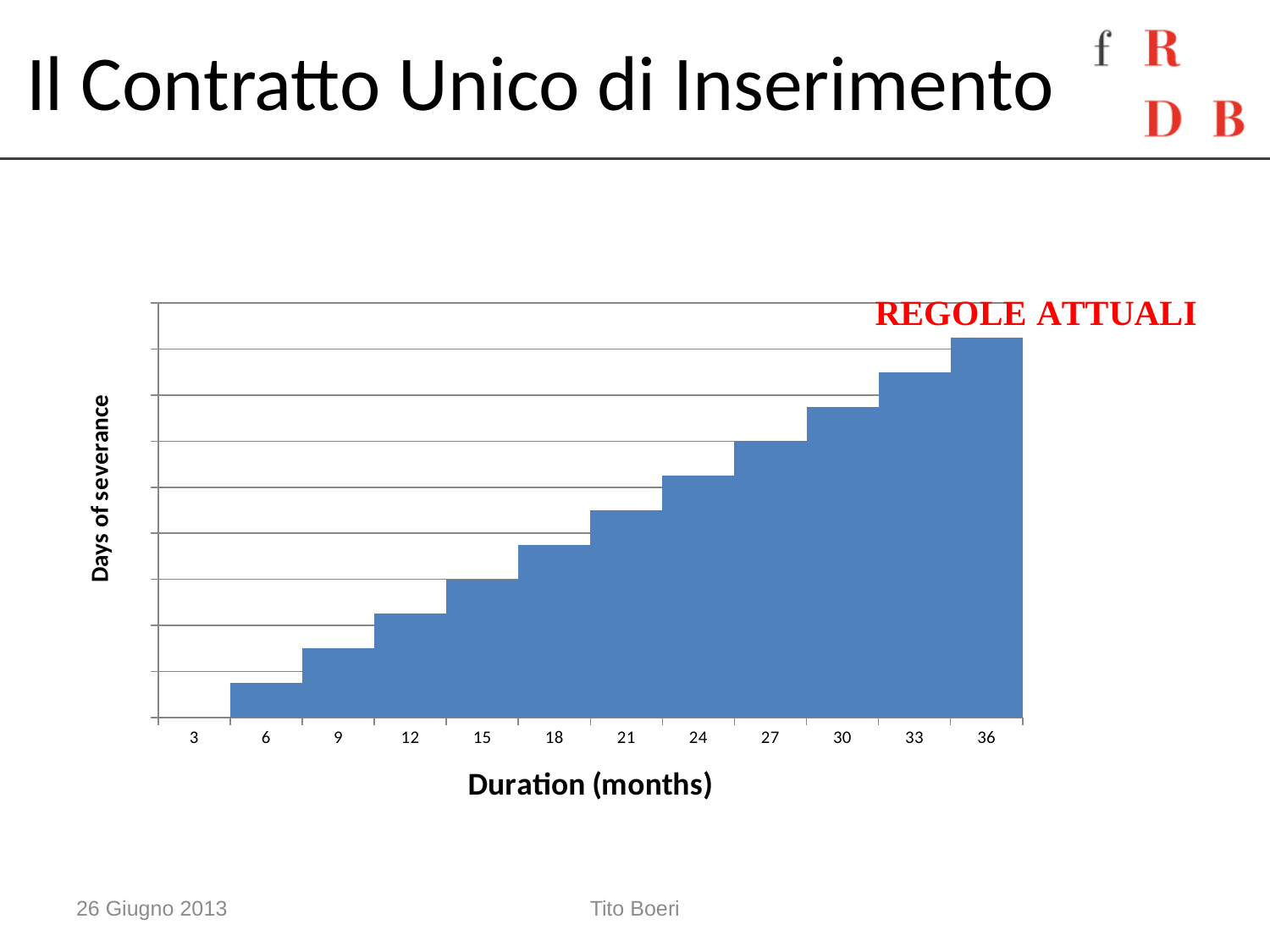
Which duration (months) has the highest days of severance in the chart? 36 Which has fewer days of severance, a duration of 9 months or 30 months? 9 months Which duration (months) has the lowest days of severance in the chart? 3 Which has more days of severance, a duration of 33 months or 18 months? 33 months Which has more days of severance, a duration of 24 months or 12 months? 24 months Do the days of severance rise or fall as the duration in months increases? rise What is the title of the y axis of the chart? Days of severance What is the title of the x axis of the chart? Duration (months) How many duration categories are shown on the x axis of the chart? 12 What kind of chart is shown on the slide? bar chart